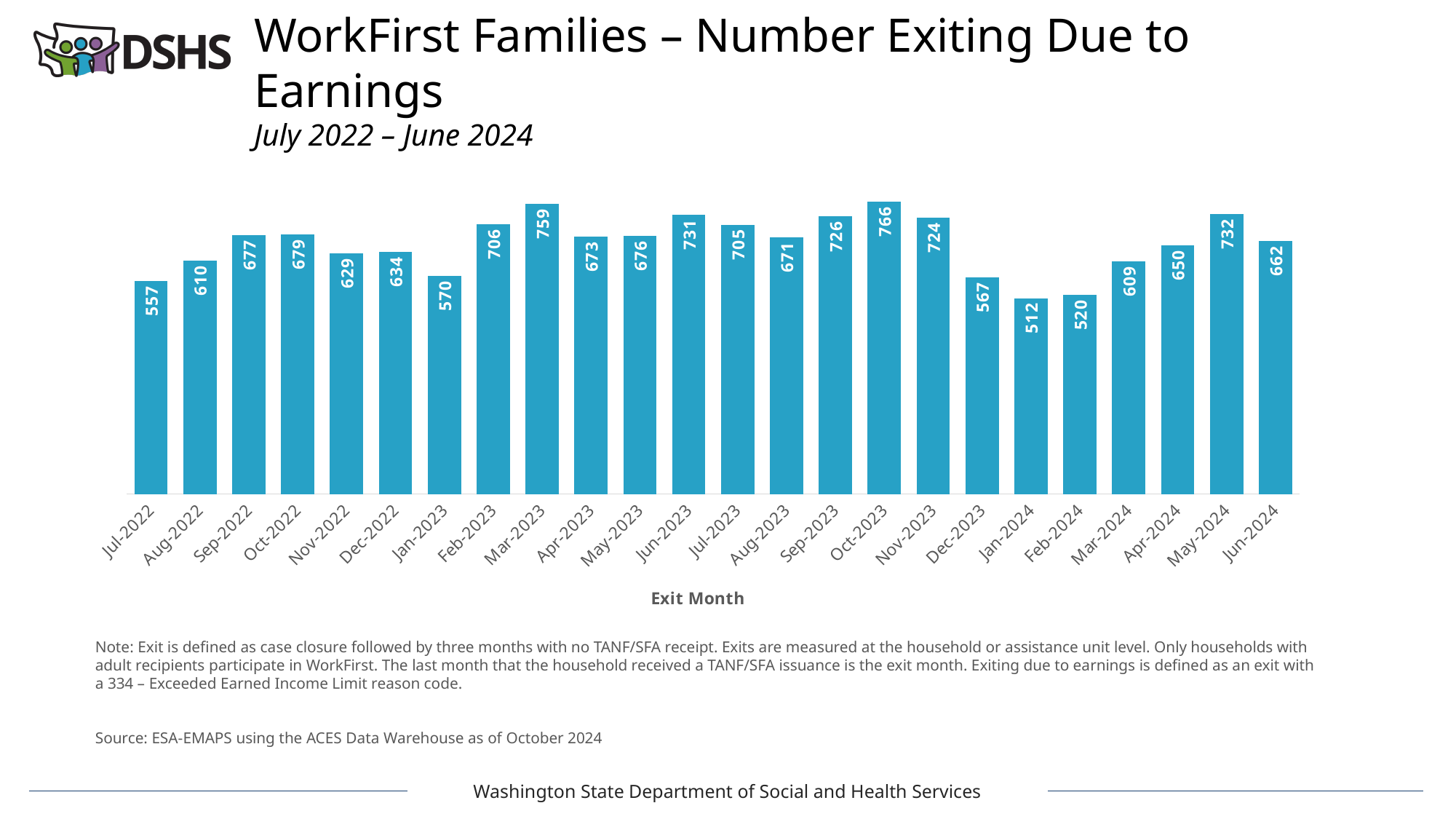
Which exit month has the lowest number of families exiting due to earnings? Jan-2024 What is the value shown for Jun-2024? 662 What is the difference between the values for Mar-2023 and Jan-2024? 247 What kind of chart is shown on the slide? Bar chart What is the value shown for Oct-2023? 766 What is the difference between the values for Jul-2022 and Aug-2022? 53 What is the label of the x axis? Exit Month How many exit months are plotted on the chart? 24 Which is larger, the value for May-2024 or the value for Jun-2023? May-2024 What is the number of WorkFirst families exiting due to earnings in Jul-2022? 557 Do the values rise or fall from Dec-2023 to Jan-2024? Fall Which exit month has the highest number of families exiting due to earnings? Oct-2023